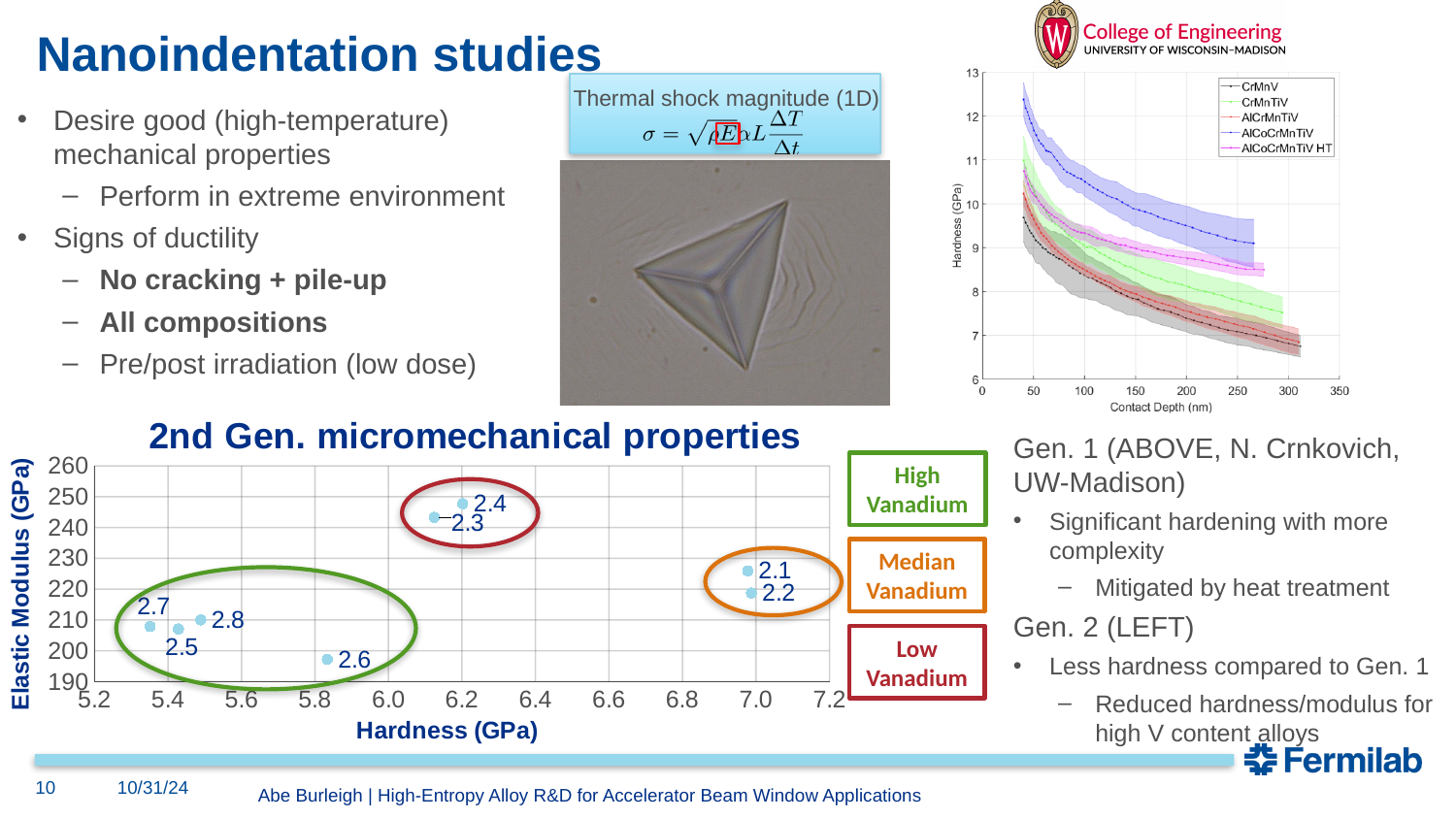
In the '2nd Gen. micromechanical properties' chart, which point has a higher elastic modulus, 2.4 or 2.6? 2.4 In the '2nd Gen. micromechanical properties' chart, which labeled point has the lowest elastic modulus? 2.6 How many series does the legend of the Hardness vs Contact Depth chart in the top right list? 5 What kind of chart is the '2nd Gen. micromechanical properties' chart? scatter chart What is the x-axis label of the '2nd Gen. micromechanical properties' chart? Hardness (GPa) How many data points are plotted in the '2nd Gen. micromechanical properties' chart? 8 In the Hardness vs Contact Depth chart in the top right, which series has the highest hardness? AlCoCrMnTiV In the '2nd Gen. micromechanical properties' chart, is the elastic modulus of point 2.2 greater or less than 230? less In the '2nd Gen. micromechanical properties' chart, which labeled point has the highest elastic modulus? 2.4 In the '2nd Gen. micromechanical properties' chart, is the hardness of point 2.1 greater or less than 6.8? greater In the '2nd Gen. micromechanical properties' chart, is the elastic modulus of point 2.8 greater or less than 200? greater In the Hardness vs Contact Depth chart in the top right, does hardness rise or fall as contact depth increases? fall